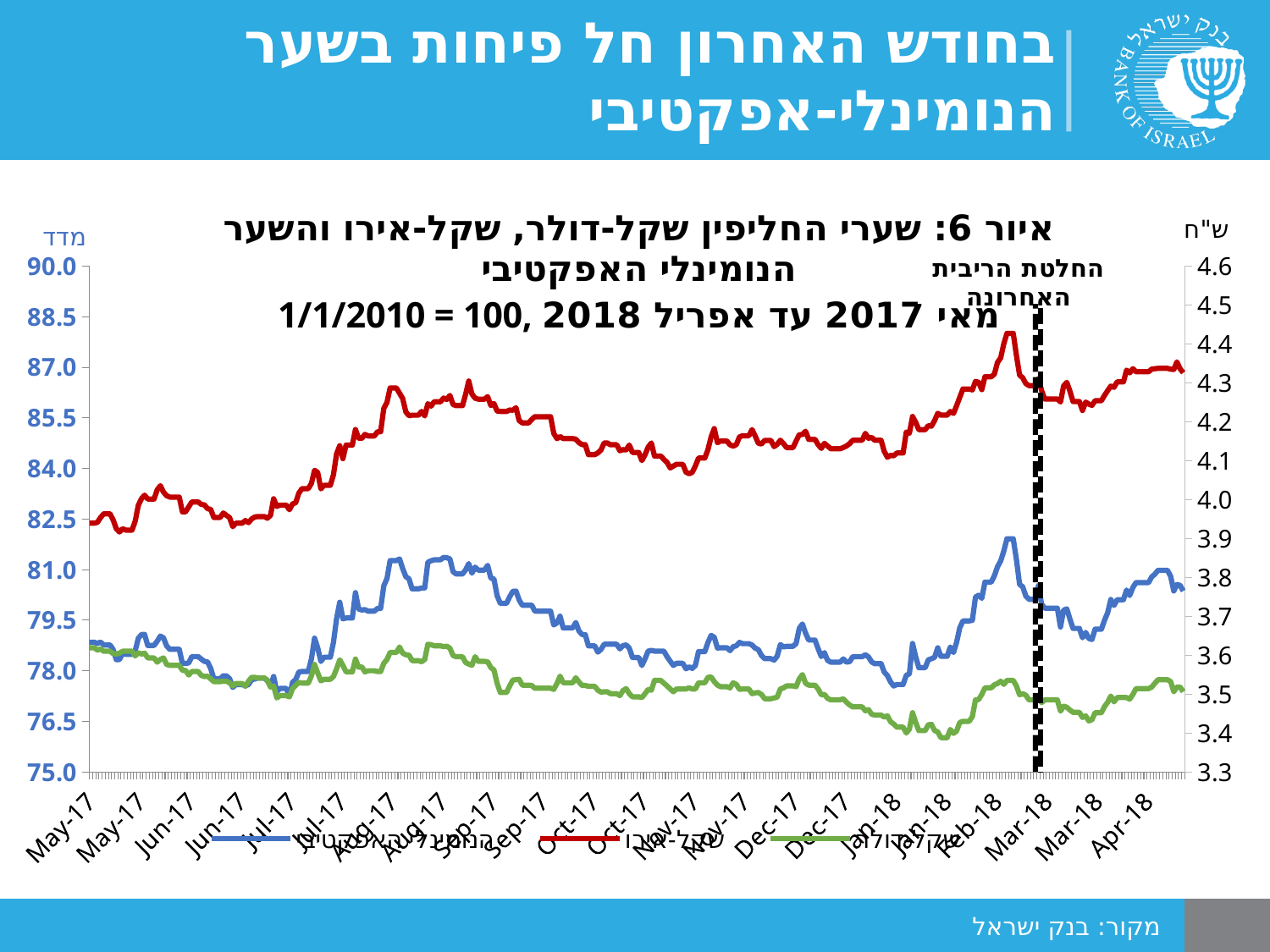
What kind of chart is shown on the slide? line chart Is the value of the שקל-אירו (red) line at its peak in Feb-18 greater or less than 4.3 on the right axis? greater Which series is drawn in red? שקל-אירו Does the שקל-אירו (red) line rise or fall between May-17 and Aug-17? rise Is the value of the שקל-דולר (green) line at its low point in Jan-18 greater or less than 3.5 on the right axis? less How many series does the chart's legend list? 3 Which line is higher on the right axis at Apr-18, שקל-אירו (red) or שקל-דולר (green)? שקל-אירו (red) Is the value of the השער הנומינלי האפקטיבי (blue) line at its low point in Jul-17 greater or less than 78.0 on the left axis? less What does the dashed vertical line near Mar-18 mark, according to its label? החלטת הריבית האחרונה Does the השער הנומינלי האפקטיבי (blue) line rise or fall from its Feb-18 peak to Mar-18? fall